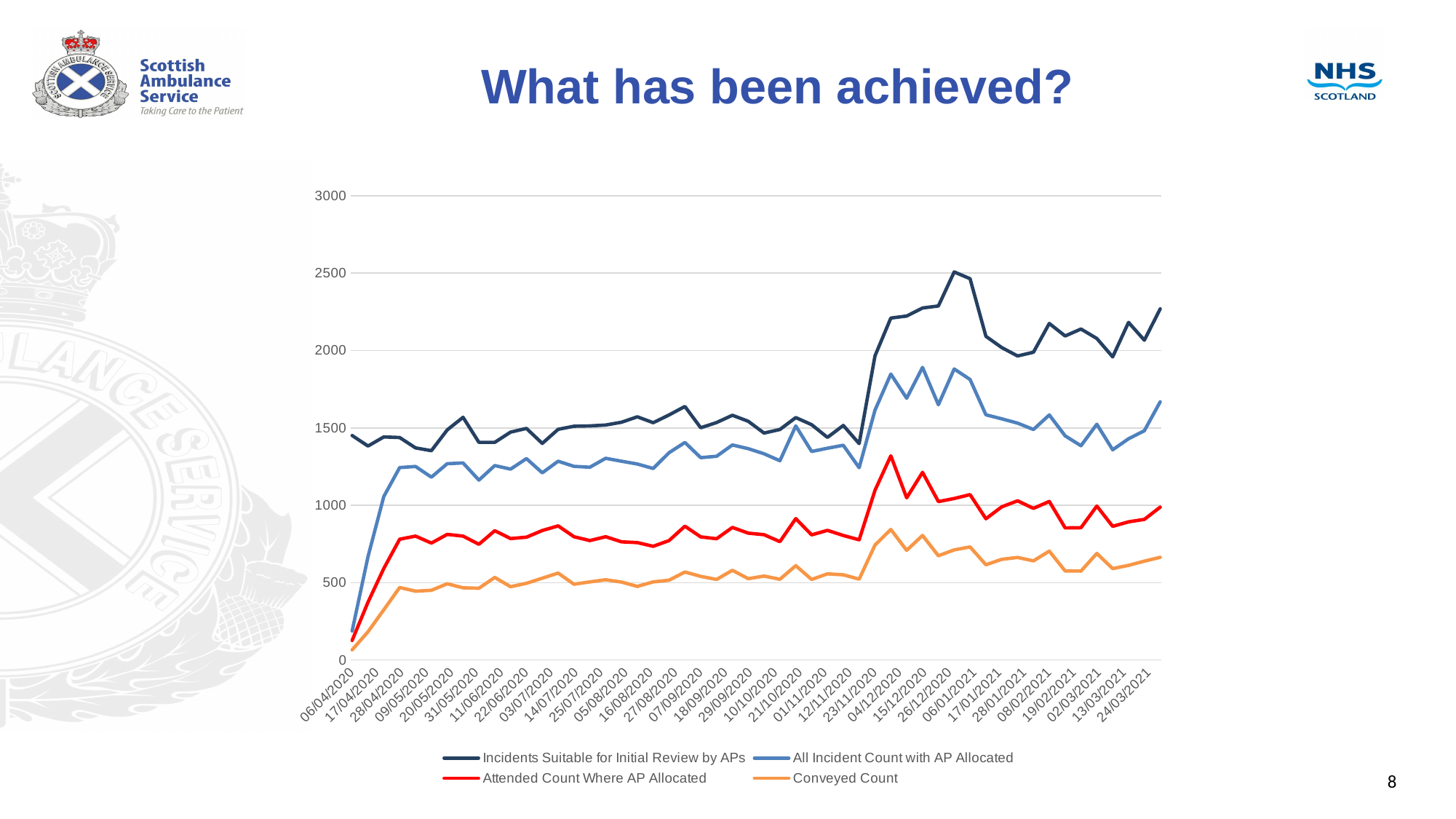
Is the value for Incidents Suitable for Initial Review by APs at 06/04/2020 greater or less than 1000? greater Is the value for All Incident Count with AP Allocated at 06/04/2020 greater or less than 500? less Does the All Incident Count with AP Allocated line rise or fall between 06/04/2020 and 28/04/2020? rise Which series reaches the highest value on the chart? Incidents Suitable for Initial Review by APs What is the highest value shown on the vertical axis? 3000 Which is larger at 24/03/2021: All Incident Count with AP Allocated or Attended Count Where AP Allocated? All Incident Count with AP Allocated How many series does the legend list? 4 Is the peak value for Attended Count Where AP Allocated around 04/12/2020 greater or less than 1000? greater What kind of chart is shown on the slide? line chart Which series has the lowest values across the whole period? Conveyed Count Which series is drawn in red? Attended Count Where AP Allocated